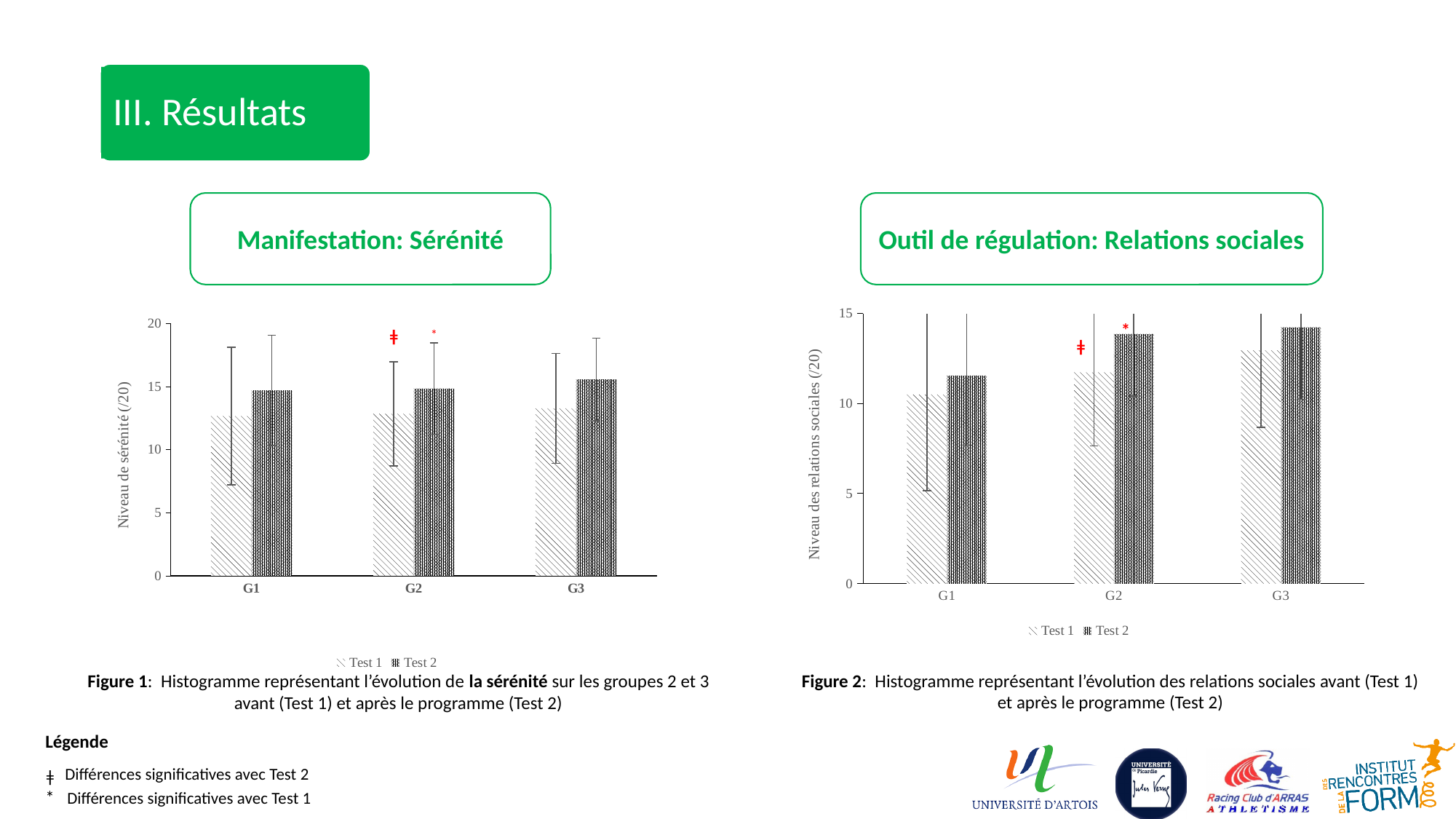
How many series does the legend of the Figure 1 chart list? 2 What is the y-axis label of the Figure 2 chart? Niveau des relations sociales (/20) What are the two series named in the legend of the Figure 2 chart? Test 1 and Test 2 In the Figure 2 chart (Relations sociales), is the Test 1 value for G1 greater or less than 10? greater In the Figure 1 chart (Sérénité), is the Test 1 value for G1 greater or less than 15? less In the Figure 2 chart (Relations sociales), is the Test 2 value for G2 greater or less than 15? less In the Figure 2 chart (Relations sociales), which group has the highest Test 1 value? G3 How many groups are shown on the x axis of the Figure 2 chart (Outil de régulation: Relations sociales)? 3 In the Figure 2 chart (Relations sociales), which group has the lowest Test 1 value? G1 What kind of chart is the Figure 1 chart (Manifestation: Sérénité)? bar chart In the Figure 1 chart (Sérénité), which is larger for G2: the Test 1 value or the Test 2 value? Test 2